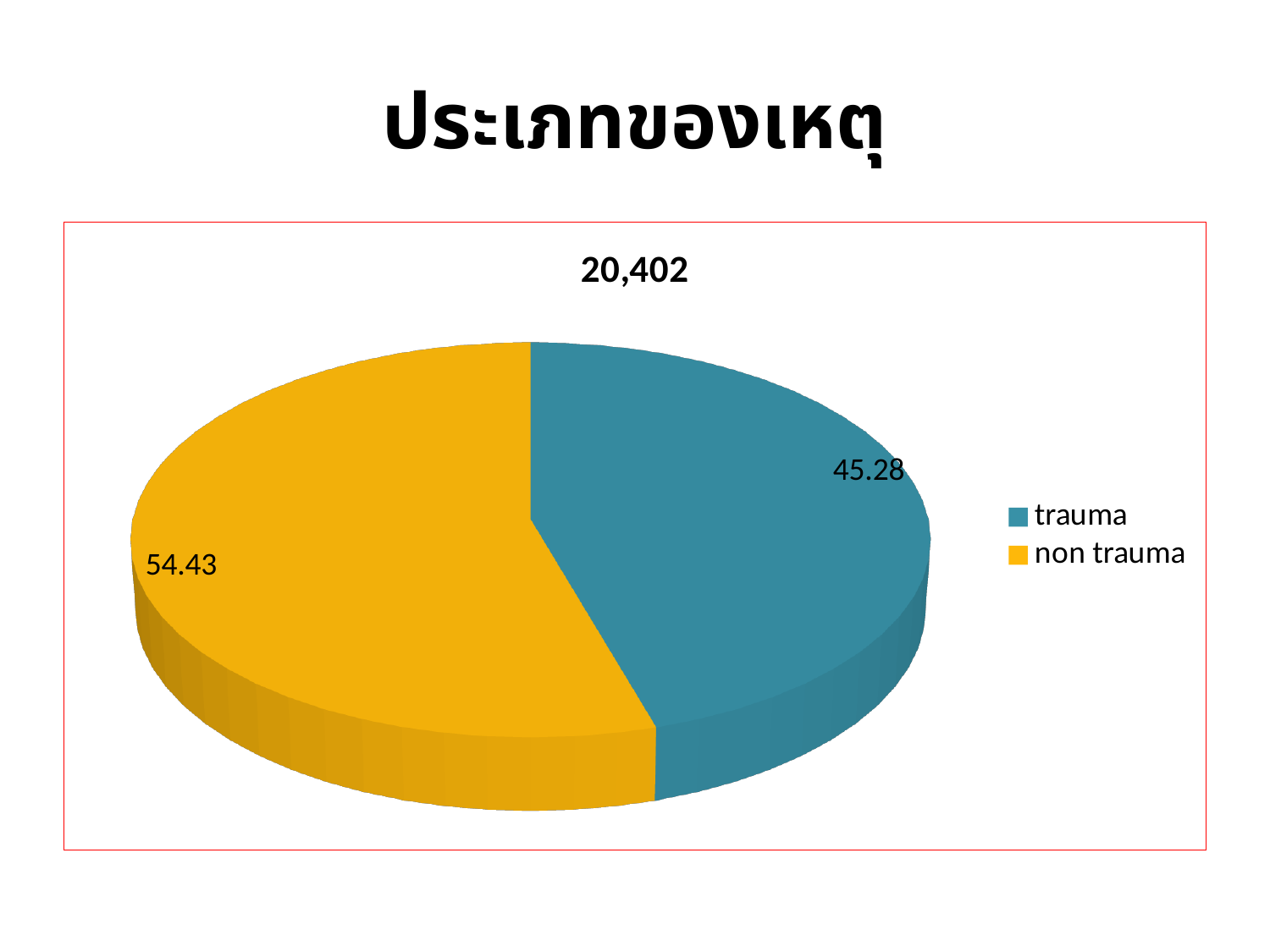
Which category has the smallest slice of the pie? trauma What kind of chart is shown on the slide? pie chart What is the value shown for the non trauma slice? 54.43 What is the value shown for the trauma slice? 45.28 Which category has the largest slice of the pie? non trauma Which is larger, the trauma slice or the non trauma slice? non trauma What is the difference between the non trauma value and the trauma value? 9.15 What is the title printed above the pie chart? 20,402 What colour is the trauma slice in the pie chart? blue How many entries does the legend list? 2 How many slices does the pie chart have? 2 What share of the pie does the non trauma slice represent, as labelled? 54.43